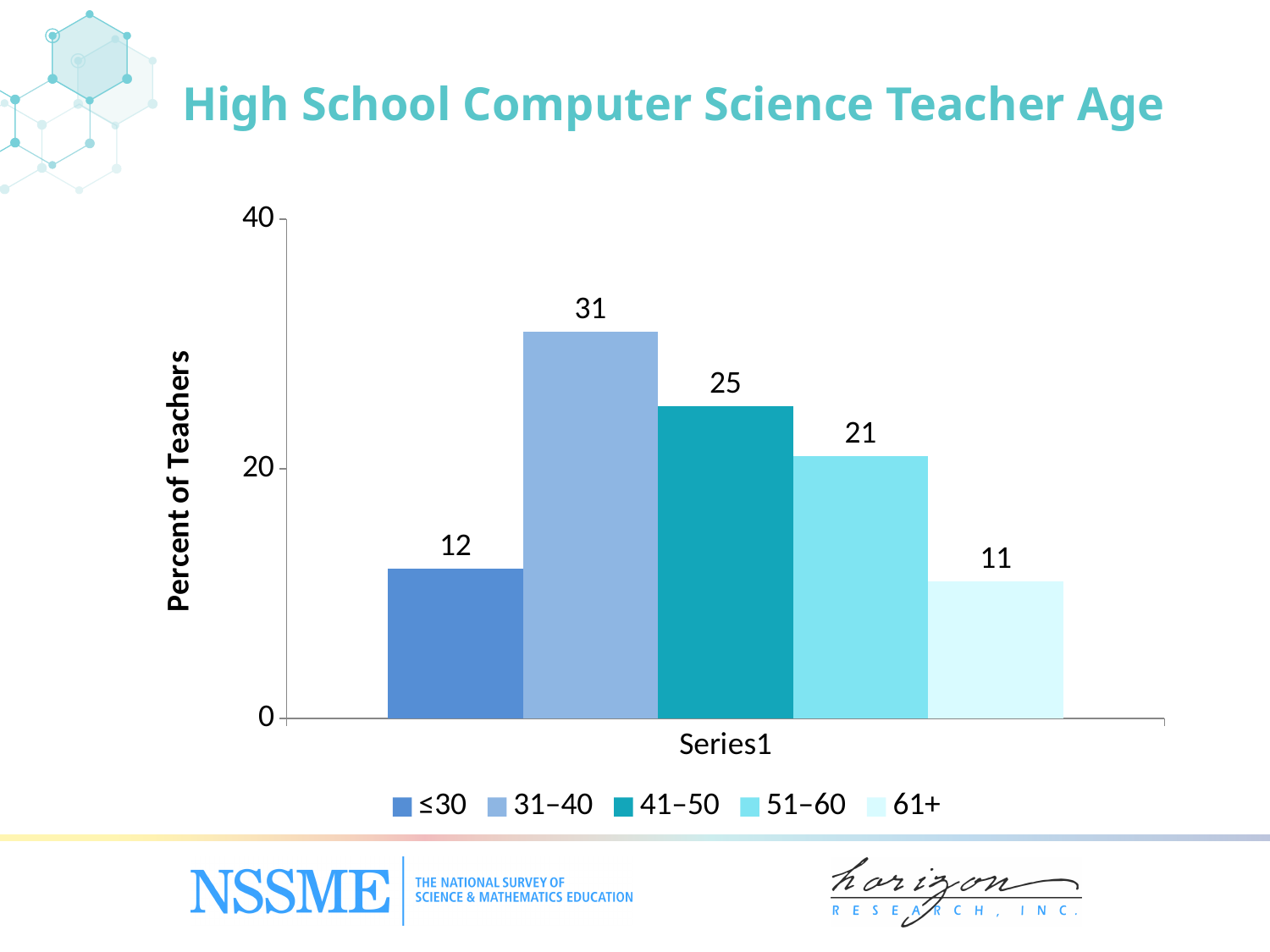
How many age groups does the legend list? 5 What is the label on the vertical axis? Percent of Teachers What is the difference in percent of teachers between the ≤30 and 61+ age groups? 1 Which age group has the highest percent of teachers? 31–40 What kind of chart is shown on the slide? bar chart Which age group has the lowest percent of teachers? 61+ What percent of high school computer science teachers are aged 41–50? 25 What percent of high school computer science teachers are aged 31–40? 31 What is the difference in percent of teachers between the 31–40 and 41–50 age groups? 6 Is the value for the 41–50 age group greater or less than 20? greater What percent of high school computer science teachers are aged 61+? 11 Which age group has a larger percent of teachers, 51–60 or ≤30? 51–60